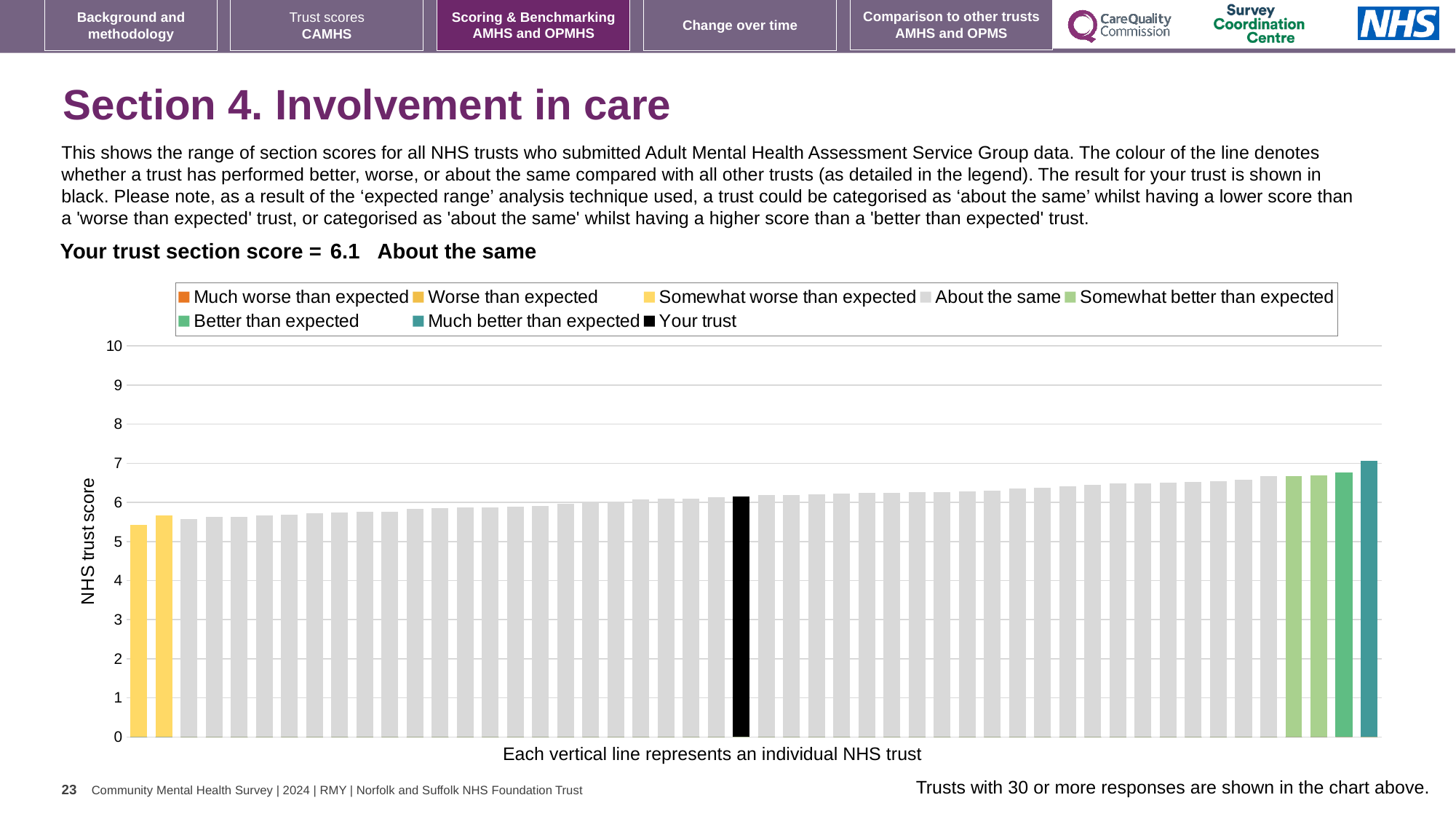
What kind of chart is shown on the slide? bar chart What is the section score for your trust shown on the slide? 6.1 Is the value of the highest bar in the chart greater or less than 8? less How many entries does the chart legend list? 8 What is the label on the vertical axis of the chart? NHS trust score How many bars are coloured as 'Worse than expected'? 0 Is the value of the lowest bar in the chart greater or less than 6? less How many bars are coloured as 'Much better than expected'? 1 Which legend category does the highest bar in the chart belong to? Much better than expected Do the bar values rise or fall from left to right across the chart? rise Is the value for your trust greater or less than 6? greater How many bars are coloured as 'Somewhat better than expected'? 2